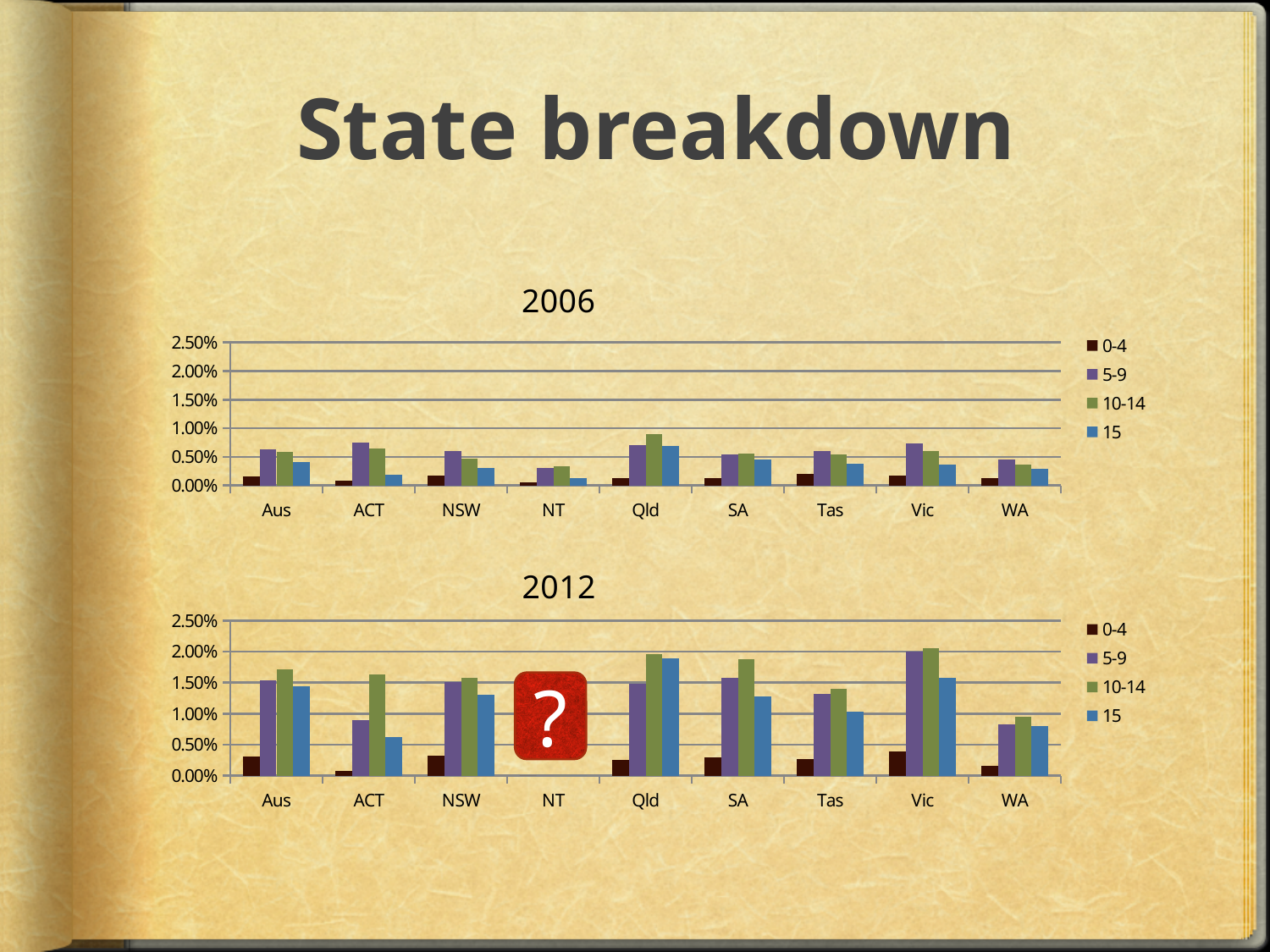
In the 2006 chart, which state has the lowest value for the 5-9 series? NT In the 2012 chart, which is larger for the 15 series: Aus or ACT? Aus What kind of chart is the 2006 chart? bar chart In the 2012 chart, which state's bars are hidden behind a red question mark? NT In the 2012 chart, is the value for Aus in the 10-14 series greater or less than 1.50%? greater How many state categories are shown on the x axis of the 2006 chart? 9 In the 2012 chart, which state has the highest value for the 5-9 series? Vic In the 2006 chart, which state has the highest value for the 10-14 series? Qld In the 2006 chart, is the value for NT in the 15 series greater or less than 0.50%? less In the 2012 chart, is the value for NSW in the 15 series greater or less than 1.50%? less How many series does the legend of the 2012 chart list? 4